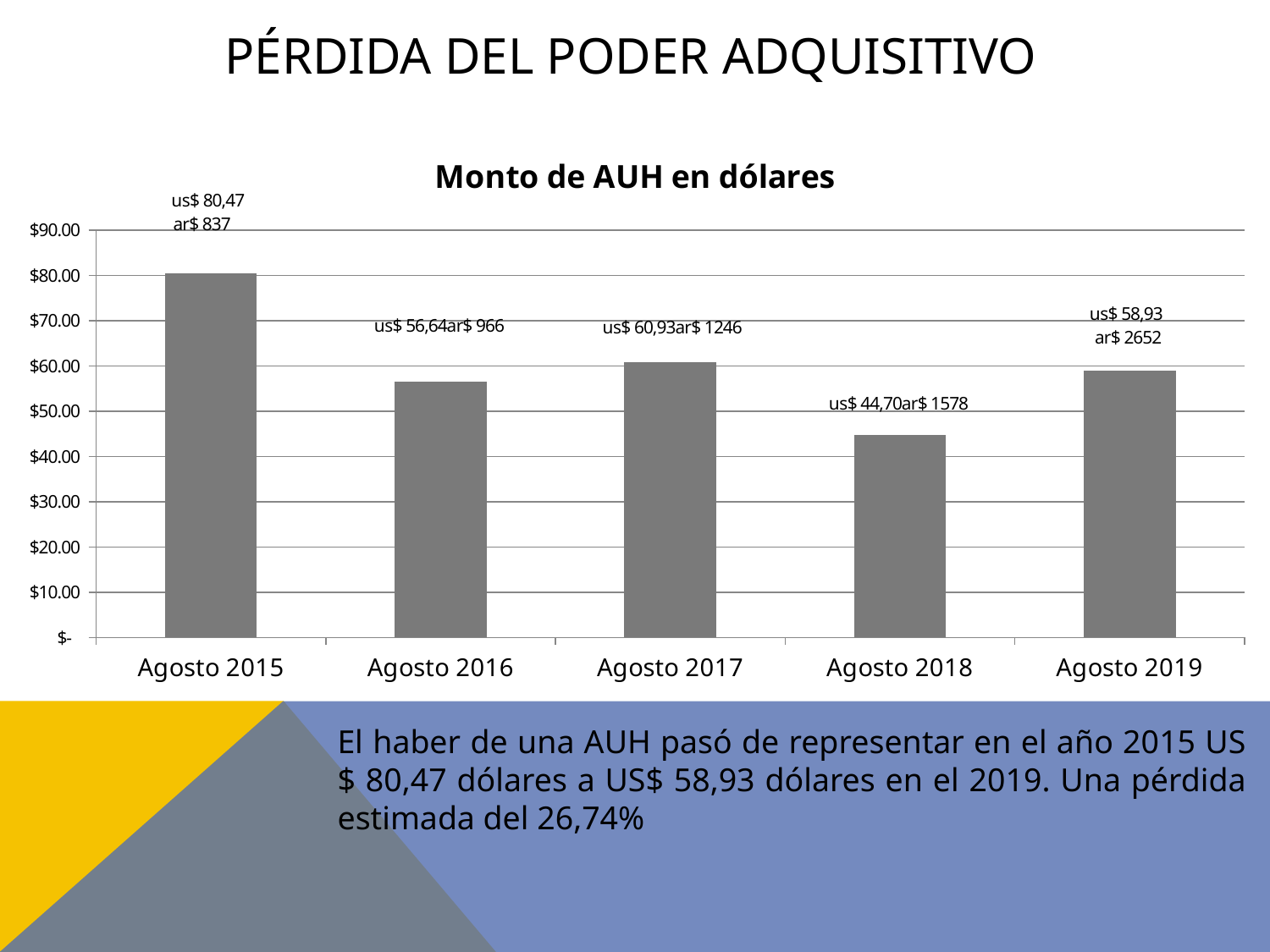
Which month has the highest dollar value in the chart? Agosto 2015 Is the value for Agosto 2018 greater or less than $50.00? less What is the value in dollars for Agosto 2018? us$ 44,70 What kind of chart is shown on the slide? bar chart Which month has the lowest dollar value in the chart? Agosto 2018 What is the difference in dollars between Agosto 2015 and Agosto 2019? us$ 21,54 What is the title of the chart? Monto de AUH en dólares What is the value in Argentine pesos (ar$) shown for Agosto 2019? ar$ 2652 What is the value for Agosto 2015 in the chart 'Monto de AUH en dólares'? us$ 80,47 How many months (categories) are shown in the chart? 5 Which has a larger dollar value, Agosto 2016 or Agosto 2017? Agosto 2017 What is the value in dollars for Agosto 2017? us$ 60,93